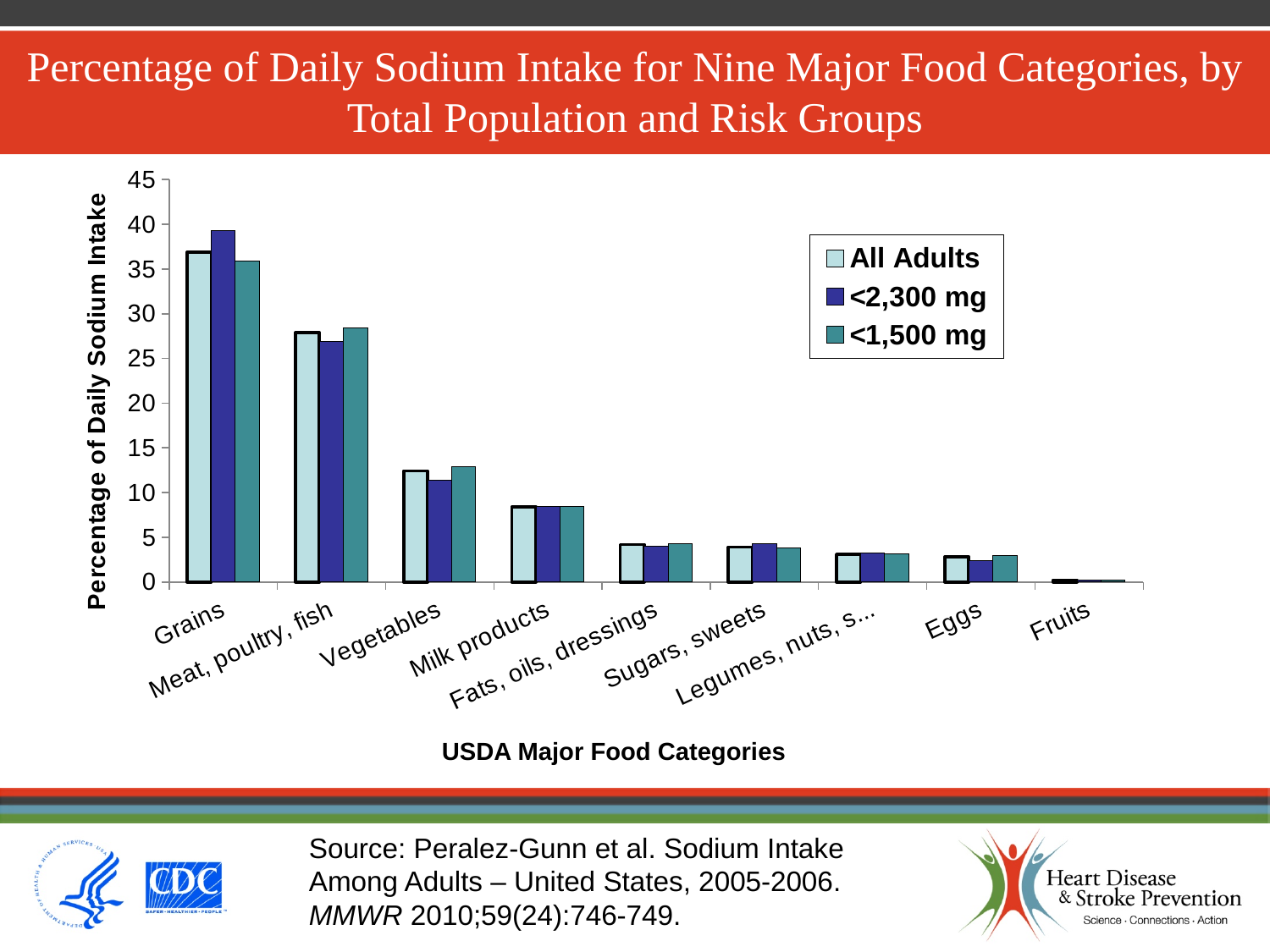
Is the All Adults value for Milk products greater or less than 5? greater Do the All Adults values generally rise or fall moving from left to right along the x axis? Fall How many food categories are shown on the x axis? 9 Is the <2,300 mg value for Meat, poultry, fish greater or less than 30? less For Grains, which series has the larger value: <2,300 mg or <1,500 mg? <2,300 mg Which food category has the highest percentage of daily sodium intake for All Adults? Grains What kind of chart is shown on the slide? Bar chart Is the <1,500 mg value for Vegetables greater or less than 10? greater For All Adults, which is larger: the value for Grains or the value for Vegetables? Grains Which food category has the lowest percentage of daily sodium intake for All Adults? Fruits How many series does the legend list? 3